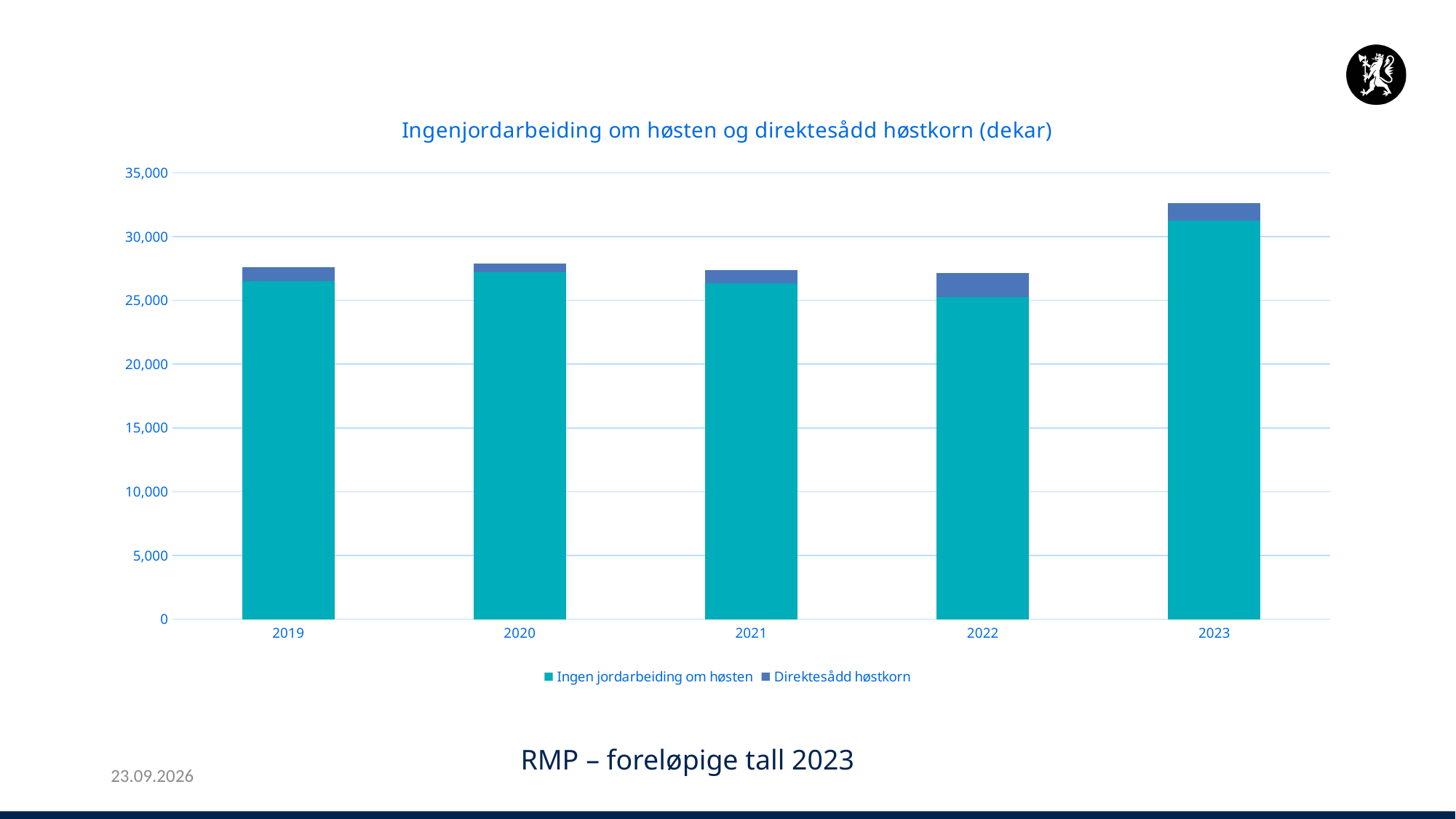
Which series is shown in teal in the chart? Ingen jordarbeiding om høsten What kind of chart is shown on the slide? bar chart Which year has the lowest value for 'Ingen jordarbeiding om høsten'? 2022 Which is larger: the total stacked bar for 2023 or for 2019? 2023 Is the total stacked bar for 2021 greater or less than 30,000? less How many series does the chart's legend list? 2 Which year has the highest total stacked bar? 2023 Which is larger: the 'Ingen jordarbeiding om høsten' value for 2020 or for 2022? 2020 Is the value for 'Ingen jordarbeiding om høsten' in 2019 greater or less than 25,000? greater How many years are shown on the x axis of the chart? 5 Is the total stacked bar for 2023 greater or less than 30,000? greater What is the title of the chart? Ingenjordarbeiding om høsten og direktesådd høstkorn (dekar)